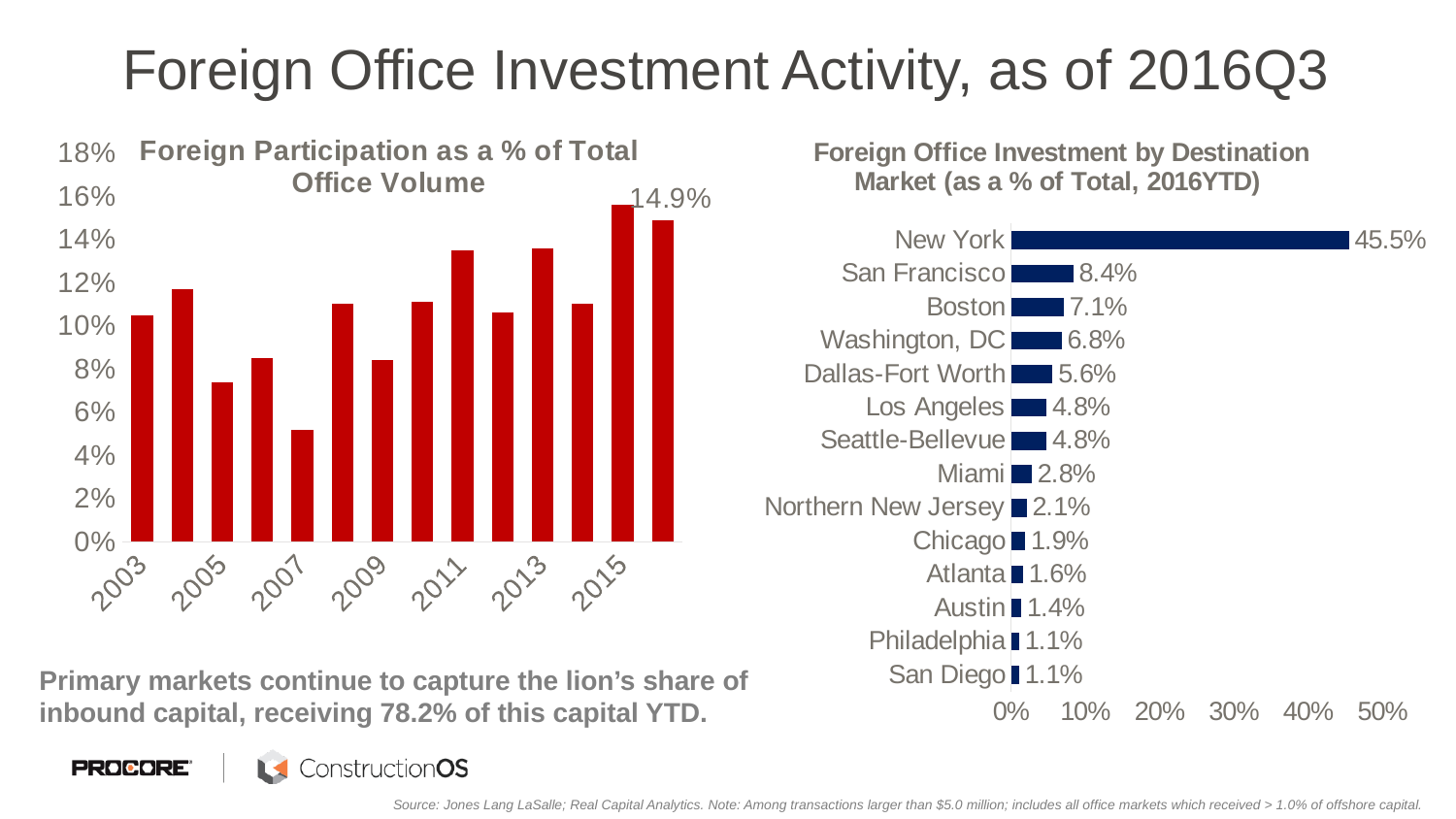
In the 'Foreign Participation as a % of Total Office Volume' chart, which year has the highest value? 2015 In the 'Foreign Office Investment by Destination Market' chart, what is the value for New York? 45.5% In the 'Foreign Participation as a % of Total Office Volume' chart, is the value for 2003 greater or less than 10%? greater How many markets are shown in the 'Foreign Office Investment by Destination Market' chart? 14 What is the title of the left chart on the slide? Foreign Participation as a % of Total Office Volume In the 'Foreign Office Investment by Destination Market' chart, which market has the highest value? New York In the 'Foreign Participation as a % of Total Office Volume' chart, is the value for 2007 greater or less than 6%? less In the 'Foreign Office Investment by Destination Market' chart, which is larger, Miami or Chicago? Miami In the 'Foreign Office Investment by Destination Market' chart, what is the difference between San Francisco and Boston? 1.3% In the 'Foreign Office Investment by Destination Market' chart, what is the value for Dallas-Fort Worth? 5.6% In the 'Foreign Participation as a % of Total Office Volume' chart, which year has the lowest value? 2007 What kind of chart is the 'Foreign Office Investment by Destination Market' chart? Bar chart